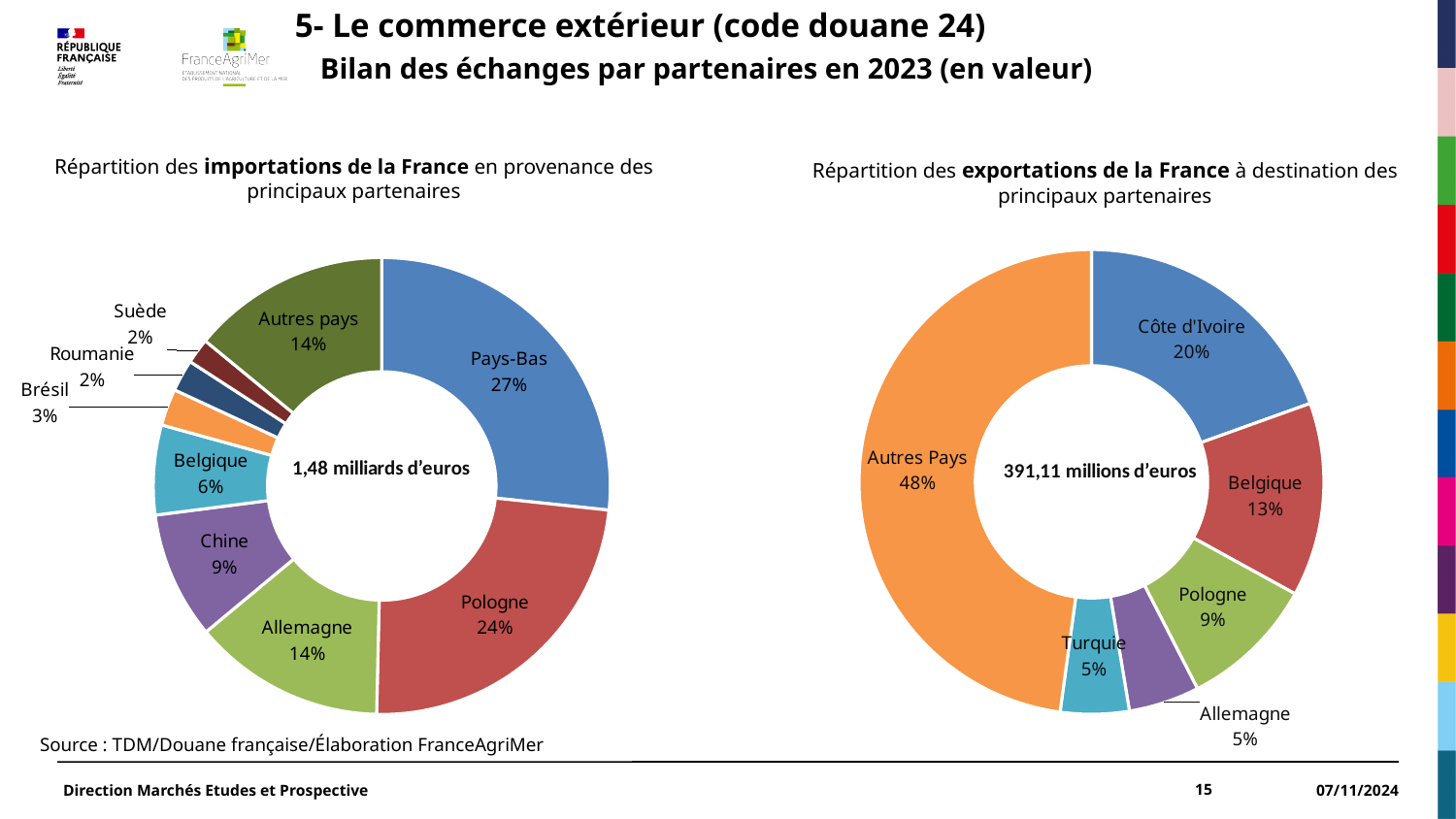
In the imports chart (left), what share does Chine represent? 9% What total value is shown in the centre of the exports chart (right)? 391,11 millions d'euros In the exports chart (right), which is larger: the share for Belgique or the share for Pologne? Belgique In the exports chart (right), what share of France's exports goes to Côte d'Ivoire? 20% In the imports chart (left), which named partner country has the largest share? Pays-Bas How many slices does the exports chart (right) have? 6 What total value is shown in the centre of the imports chart (left)? 1,48 milliards d'euros How many slices does the imports chart (left) have? 9 In the imports chart (left), what share of France's imports comes from Pays-Bas? 27% What type of chart is used for the exports chart (right)? Pie chart (donut) In the imports chart (left), what is the difference in percentage points between Pays-Bas and Pologne? 3 In the exports chart (right), which slice is the largest? Autres Pays